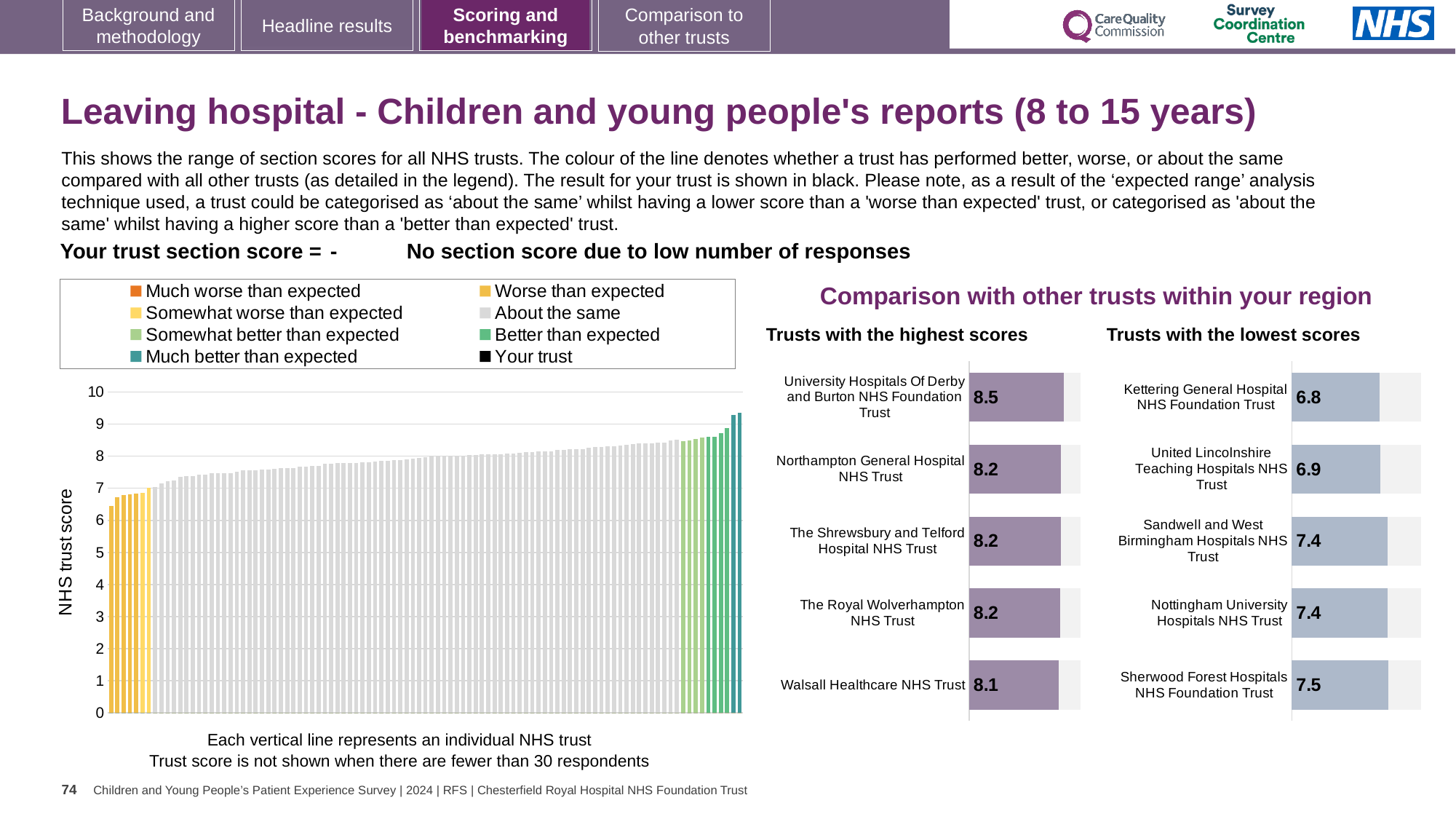
In the 'Trusts with the highest scores' chart, what is the score for Walsall Healthcare NHS Trust? 8.1 In the NHS trust score chart on the left, do the bar values rise or fall from left to right? rise In the 'Trusts with the lowest scores' chart, which has the higher score: Kettering General Hospital NHS Foundation Trust or United Lincolnshire Teaching Hospitals NHS Trust? United Lincolnshire Teaching Hospitals NHS Trust In the 'Trusts with the highest scores' chart, what is the difference between the scores of University Hospitals Of Derby and Burton NHS Foundation Trust and Walsall Healthcare NHS Trust? 0.4 In the 'Trusts with the lowest scores' chart, what is the difference between the scores of Sherwood Forest Hospitals NHS Foundation Trust and Kettering General Hospital NHS Foundation Trust? 0.7 In the 'Trusts with the lowest scores' chart, what is the score for Kettering General Hospital NHS Foundation Trust? 6.8 In the 'Trusts with the highest scores' chart, what is the score for University Hospitals Of Derby and Burton NHS Foundation Trust? 8.5 In the 'Trusts with the lowest scores' chart, which trust has the lowest score? Kettering General Hospital NHS Foundation Trust How many trusts are listed in the 'Trusts with the highest scores' chart? 5 In the NHS trust score chart on the left, is the value of the leftmost bar greater or less than 7? less How many entries does the legend of the NHS trust score chart on the left list? 8 In the 'Trusts with the lowest scores' chart, which trust has the highest score? Sherwood Forest Hospitals NHS Foundation Trust